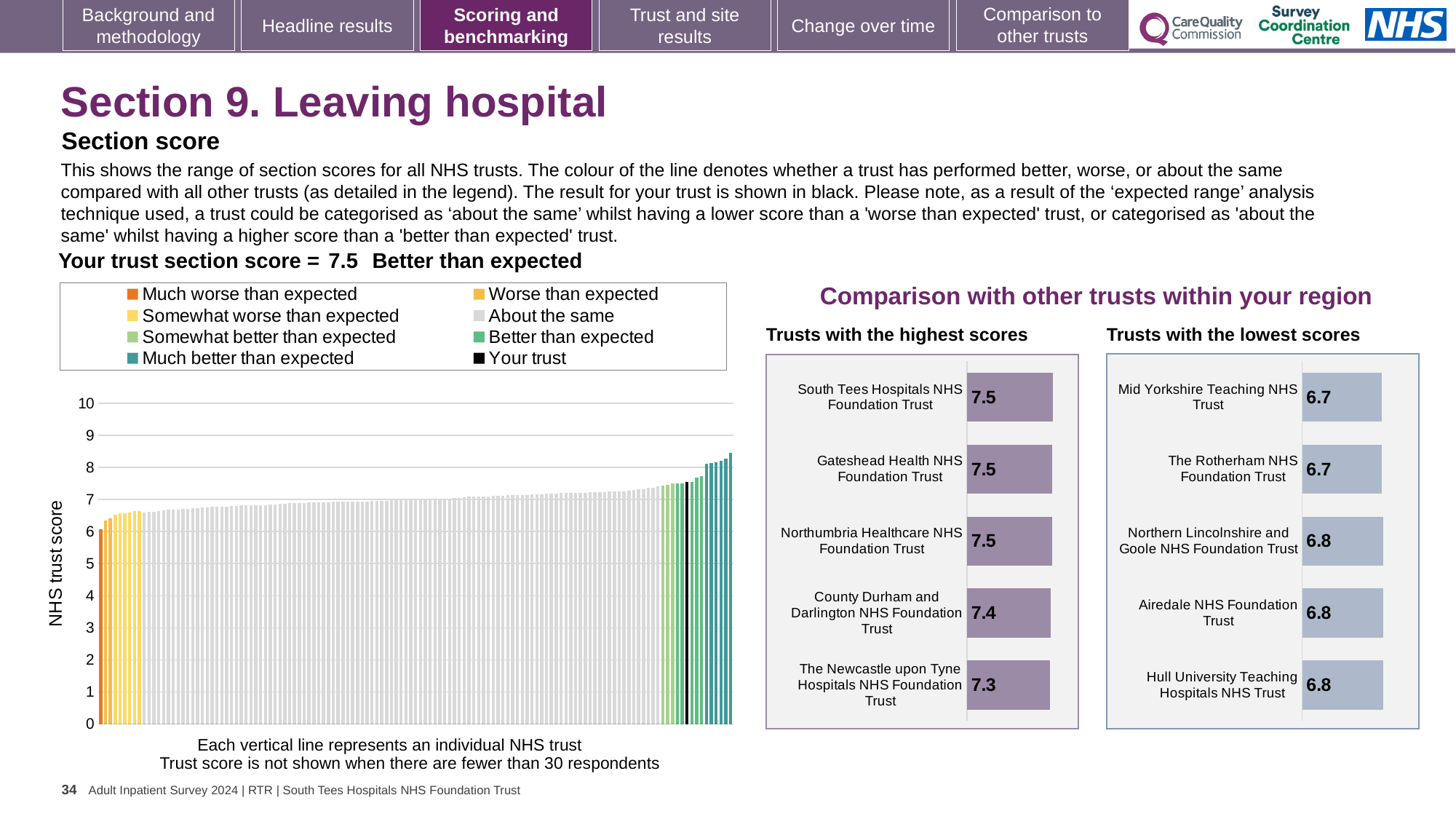
What kind of chart is the 'Trusts with the highest scores' chart? Bar chart In the NHS trust score chart on the left, is the value of the tallest bar greater or less than 8? greater How many entries does the legend of the NHS trust score chart on the left list? 8 In the 'Trusts with the lowest scores' chart, what is the difference between the scores of Hull University Teaching Hospitals NHS Trust and Mid Yorkshire Teaching NHS Trust? 0.1 How many trusts are listed in the 'Trusts with the lowest scores' chart? 5 What is the y-axis label of the NHS trust score chart on the left? NHS trust score In the NHS trust score chart on the left, do the bar heights rise or fall from left to right? Rise In the 'Trusts with the highest scores' chart, which trust has the lowest score? The Newcastle upon Tyne Hospitals NHS Foundation Trust In the 'Trusts with the lowest scores' chart, what is the score for Airedale NHS Foundation Trust? 6.8 In the 'Trusts with the highest scores' chart, which has the higher score: County Durham and Darlington NHS Foundation Trust or The Newcastle upon Tyne Hospitals NHS Foundation Trust? County Durham and Darlington NHS Foundation Trust In the 'Trusts with the highest scores' chart, what is the difference between the scores of South Tees Hospitals NHS Foundation Trust and The Newcastle upon Tyne Hospitals NHS Foundation Trust? 0.2 In the 'Trusts with the highest scores' chart, what is the score for Gateshead Health NHS Foundation Trust? 7.5